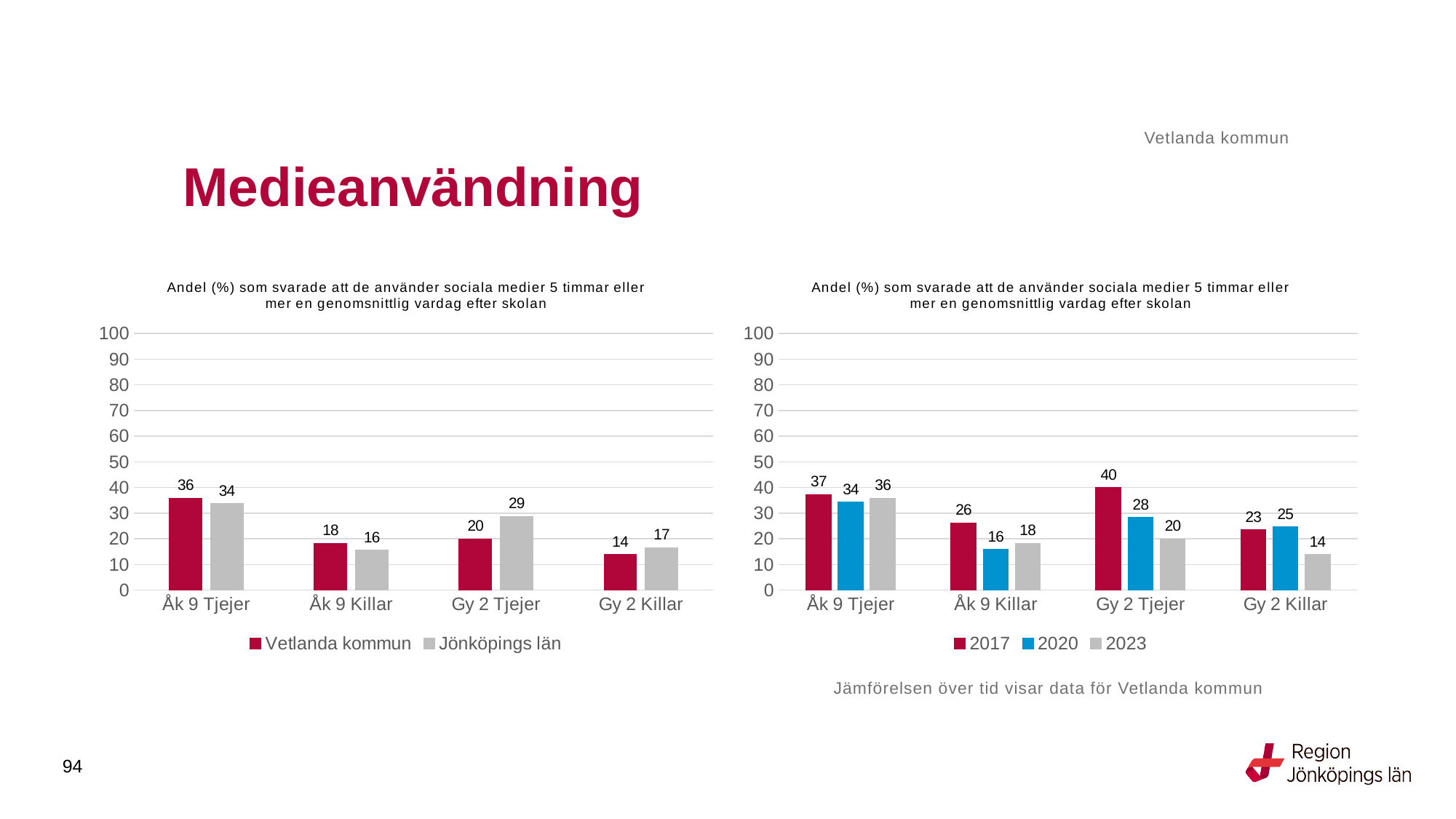
In the left chart, which is larger for Åk 9 Killar: Vetlanda kommun or Jönköpings län? Vetlanda kommun In the right chart, do the values for Gy 2 Tjejer rise or fall from 2017 to 2023? fall In the left chart, what is the difference between Vetlanda kommun and Jönköpings län for Gy 2 Tjejer? 9 In the right chart, what is the value for 2017 for Gy 2 Tjejer? 40 How many series does the legend of the right chart list? 3 In the left chart, which category has the lowest value for Vetlanda kommun? Gy 2 Killar In the right chart, what is the value for 2023 for Gy 2 Killar? 14 In the right chart, which category has the highest value for 2017? Gy 2 Tjejer What kind of chart is the left chart? bar chart In the left chart, what is the value for Jönköpings län for Gy 2 Tjejer? 29 In the right chart, what is the difference between 2017 and 2023 for Gy 2 Tjejer? 20 In the left chart, what is the value for Vetlanda kommun for Åk 9 Tjejer? 36